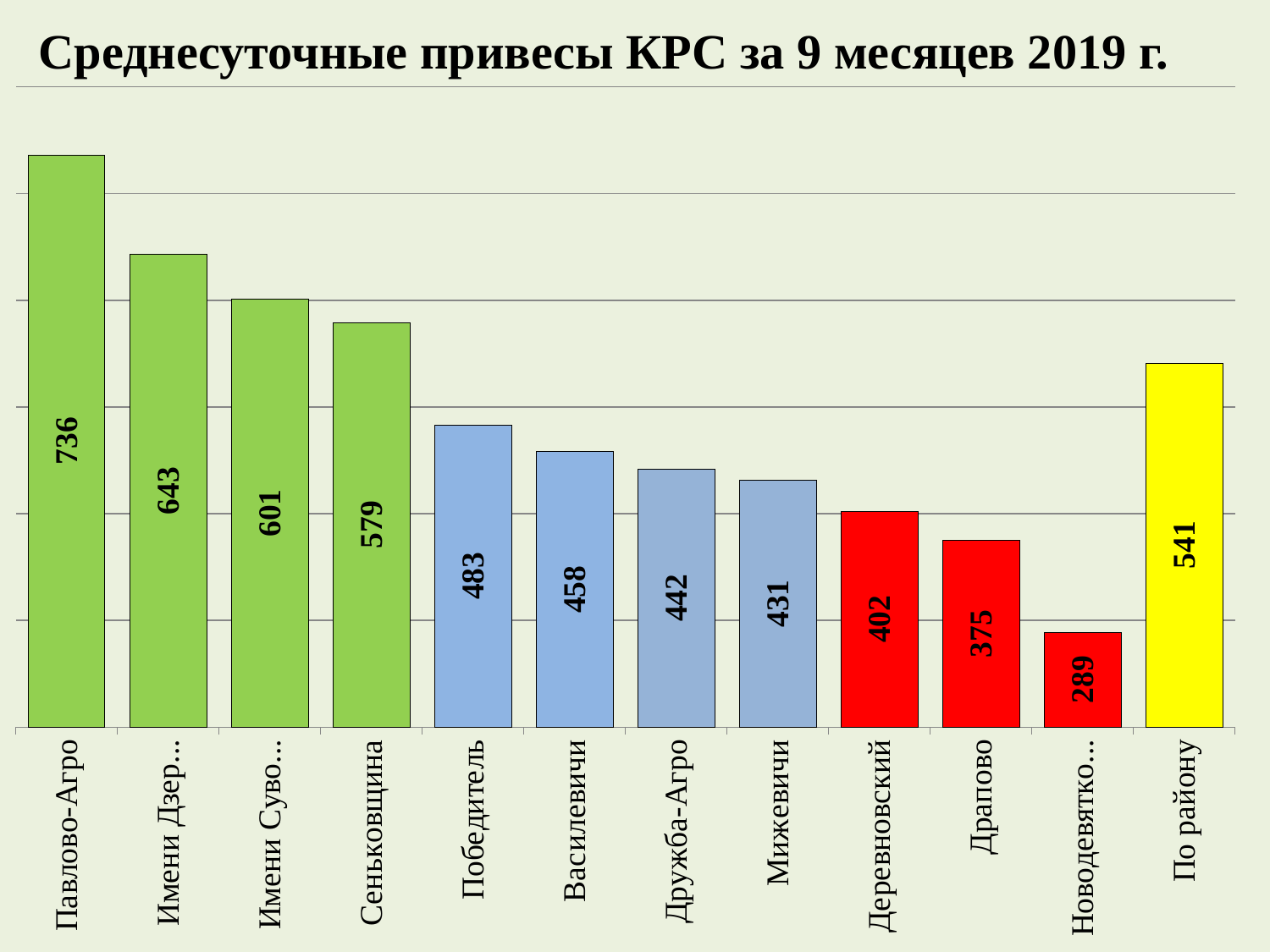
What is the title of the chart? Среднесуточные привесы КРС за 9 месяцев 2019 г. What value is shown for Сеньковщина? 579 Which category has the highest value on the chart? Павлово-Агро What value is shown for По району? 541 What is the lowest value shown on the chart? 289 Which is larger, the value for Дружба-Агро or the value for Мижевичи? Дружба-Агро What is the difference between the values for Павлово-Агро and По району? 195 What is the average daily weight gain value shown for Павлово-Агро? 736 What value is shown for Драпово? 375 What kind of chart is shown on the slide? Bar chart How many bars are shown on the chart? 12 What is the difference between the values for Победитель and Василевичи? 25